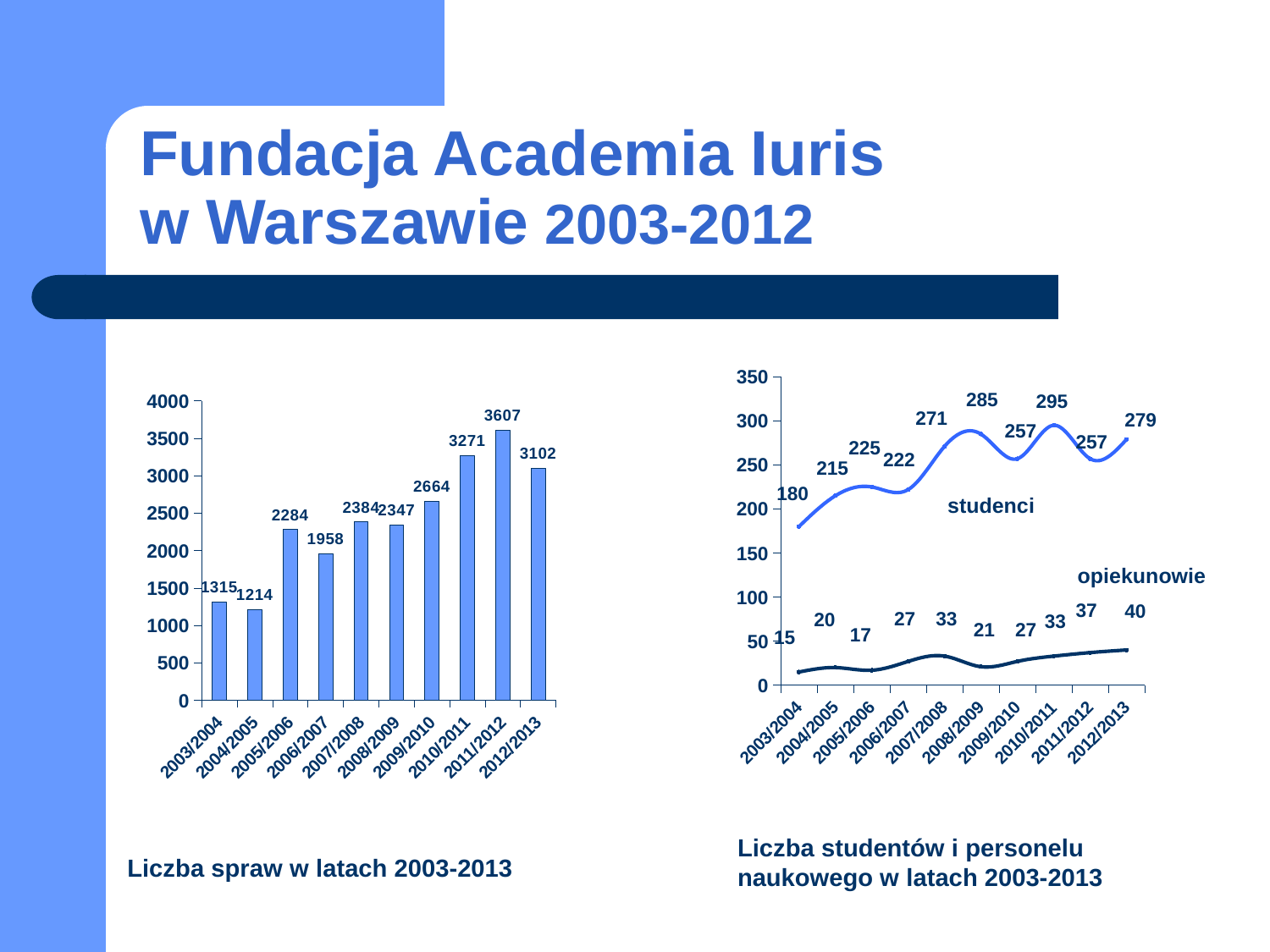
In the right chart (Liczba studentów i personelu naukowego), what is the value for opiekunowie in 2012/2013? 40 How many series are plotted in the right chart (Liczba studentów i personelu naukowego)? 2 In the left chart (Liczba spraw w latach 2003-2013), what is the difference between the values for 2011/2012 and 2012/2013? 505 In the right chart (Liczba studentów i personelu naukowego), what is the difference between studenci and opiekunowie in 2012/2013? 239 In the right chart (Liczba studentów i personelu naukowego), which is larger: studenci in 2003/2004 or studenci in 2004/2005? 2004/2005 In the right chart (Liczba studentów i personelu naukowego), what is the value for studenci in 2007/2008? 271 In the left chart (Liczba spraw w latach 2003-2013), how many years are shown on the x axis? 10 In the left chart (Liczba spraw w latach 2003-2013), what is the value for 2011/2012? 3607 In the right chart (Liczba studentów i personelu naukowego), in which year is the studenci value highest? 2010/2011 In the left chart (Liczba spraw w latach 2003-2013), which year has the lowest value? 2004/2005 In the left chart (Liczba spraw w latach 2003-2013), what is the value for 2006/2007? 1958 What kind of chart is the left chart (Liczba spraw w latach 2003-2013)? bar chart